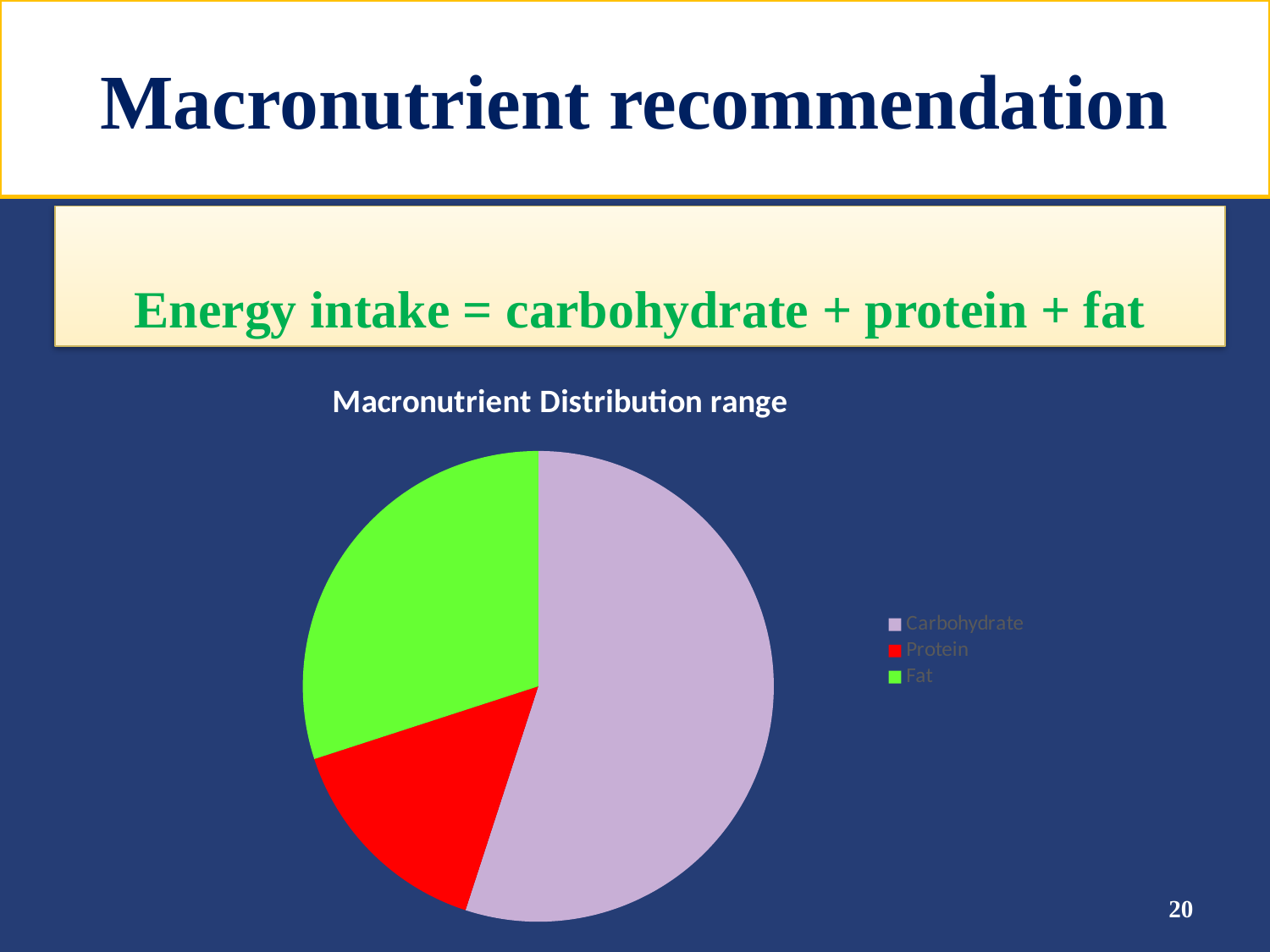
How many entries does the chart legend list? 3 How many slices does the pie chart have? 3 Which slice is larger, Fat or Protein? Fat What is the title of the chart? Macronutrient Distribution range Which macronutrient has the largest slice of the pie? Carbohydrate Which colour represents Protein in the pie chart? red What kind of chart is shown on the slide? pie chart Which macronutrient has the smallest slice of the pie? Protein Which slice is larger, Carbohydrate or Fat? Carbohydrate